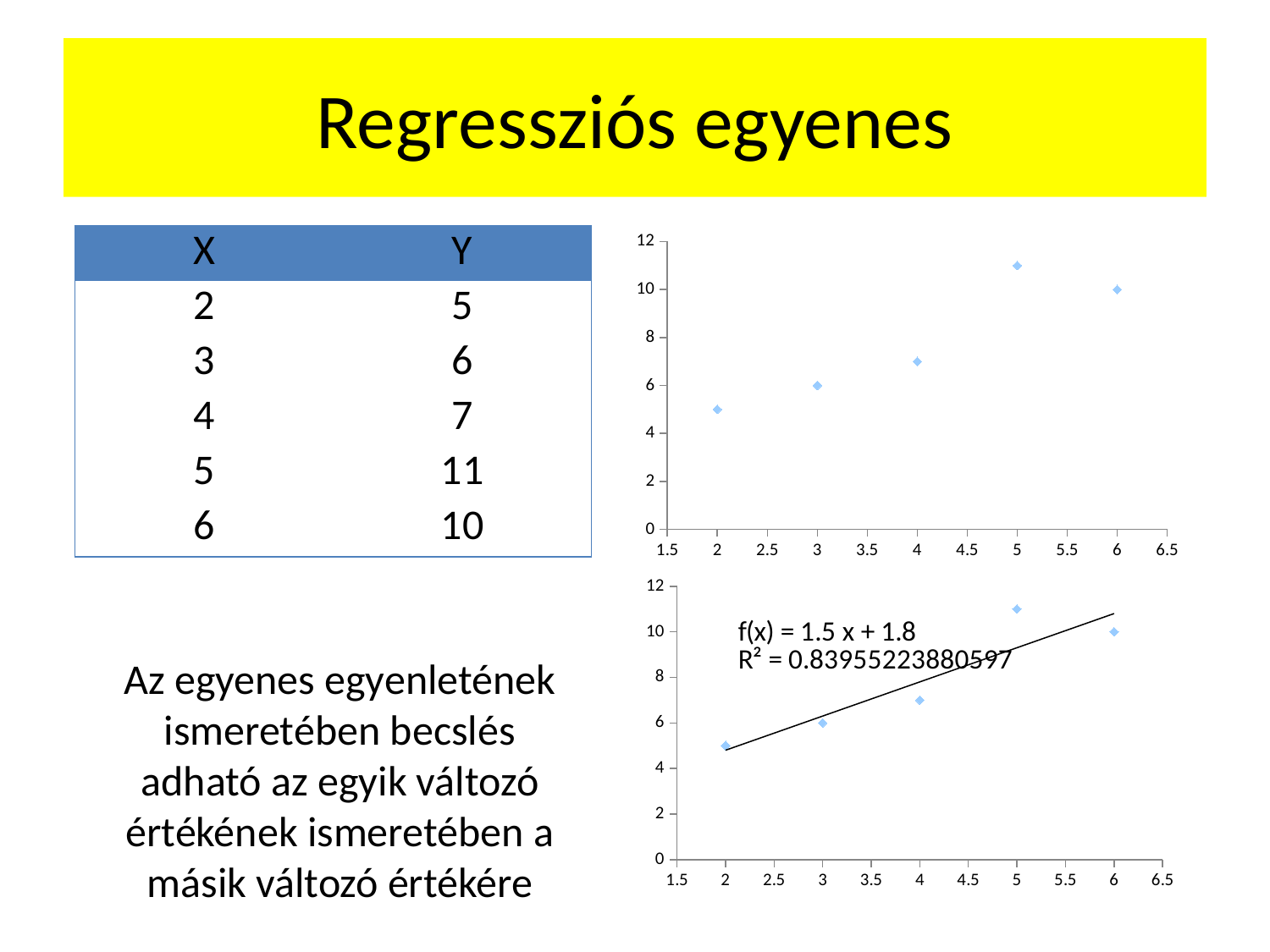
What kind of chart is the top chart on the right of the slide? scatter chart In the bottom chart, is the y value of the point at x = 2 greater or less than 6? less How many data points are plotted in the top chart? 5 What is the equation of the trendline shown in the bottom chart? f(x) = 1.5 x + 1.8 In the top chart, what is the difference between the y value at x = 6 and the y value at x = 3? 4 In the top chart, do the y values generally rise or fall as x increases? rise In the top chart, at which x value is the plotted y value highest? 5 In the top chart, is the y value of the point at x = 5 greater or less than 10? greater In the bottom chart, what is the y value of the point at x = 3? 6 In the top chart, what is the y value of the point at x = 6? 10 In the top chart, at which x value is the plotted y value lowest? 2 In the bottom chart, which point has the larger y value, the one at x = 4 or the one at x = 3? x = 4